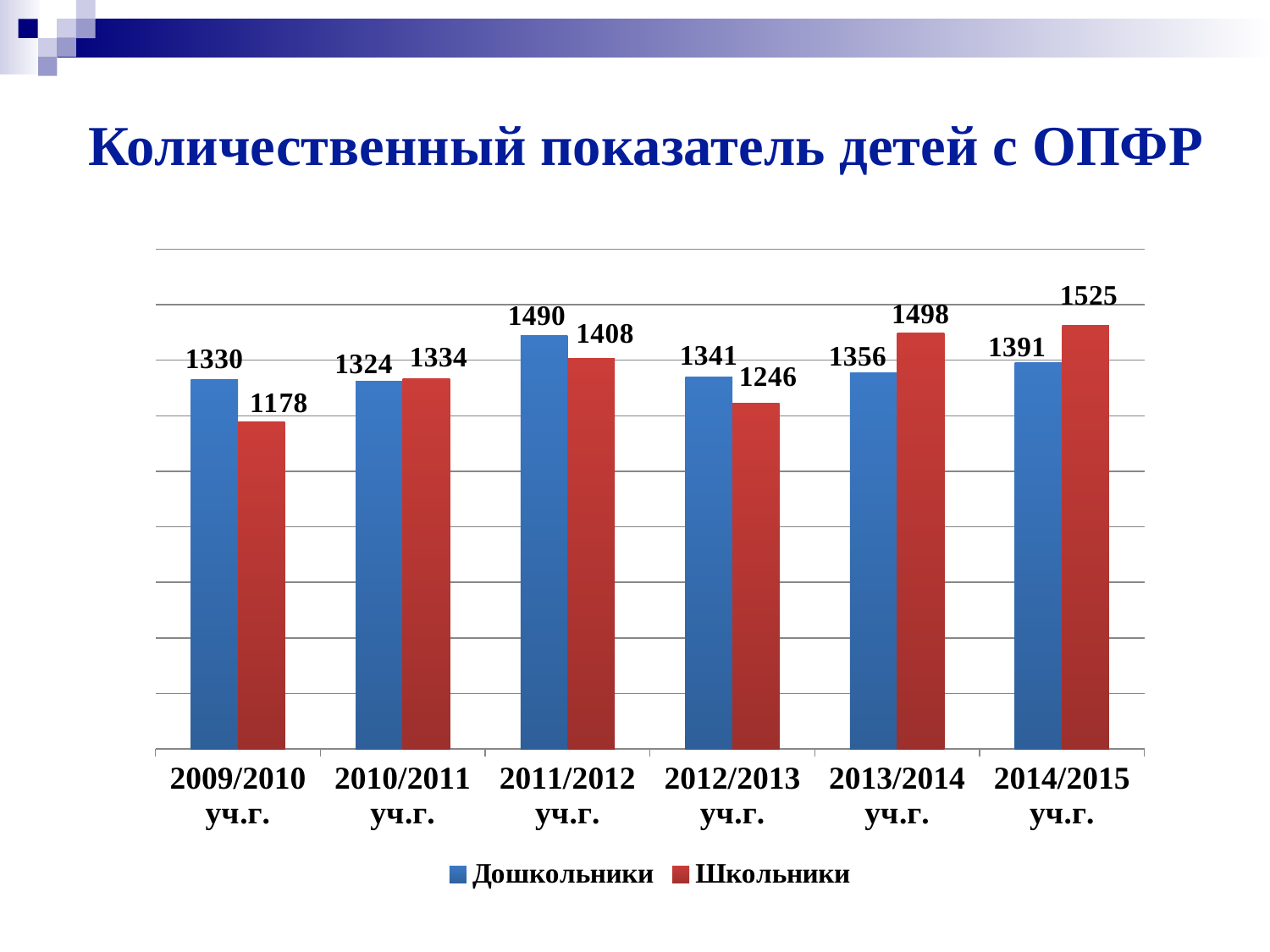
How many series does the legend list? 2 What is the value for Школьники in 2009/2010 уч.г.? 1178 What is the difference between Дошкольники and Школьники in 2009/2010 уч.г.? 152 In which academic year is the value for Дошкольники the lowest? 2010/2011 уч.г. In which academic year is the value for Школьники the highest? 2014/2015 уч.г. What is the difference between Школьники and Дошкольники in 2014/2015 уч.г.? 134 In 2012/2013 уч.г., which series has the larger value, Дошкольники or Школьники? Дошкольники What is the value for Дошкольники in 2011/2012 уч.г.? 1490 Which colour represents Школьники in the chart? Red What is the value for Школьники in 2013/2014 уч.г.? 1498 What kind of chart is shown on the slide? Bar chart How many academic years are shown on the x axis? 6